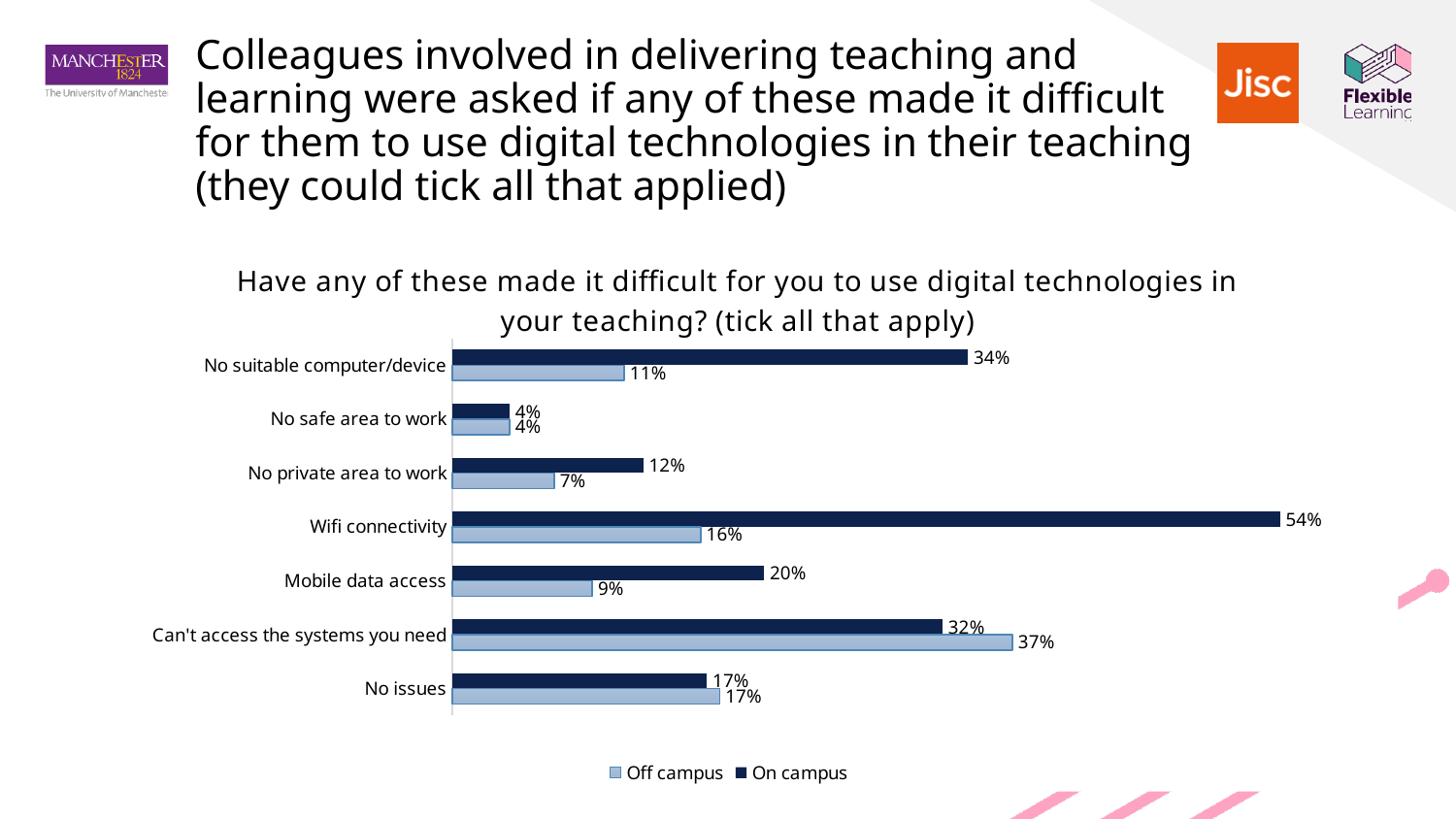
Which category has the lowest Off campus value? No safe area to work For Can't access the systems you need, which is larger: the On campus value or the Off campus value? Off campus What kind of chart is shown on the slide? bar chart How many series does the legend list? 2 Which category has the highest On campus value? Wifi connectivity What is the difference between the On campus and Off campus values for Mobile data access? 11% What is the Off campus value for No suitable computer/device? 11% What is the Off campus value for Can't access the systems you need? 37% What is the difference between the On campus and Off campus values for Wifi connectivity? 38% What is the On campus value for Wifi connectivity? 54% How many categories are shown on the chart? 7 Which series is shown in dark navy? On campus